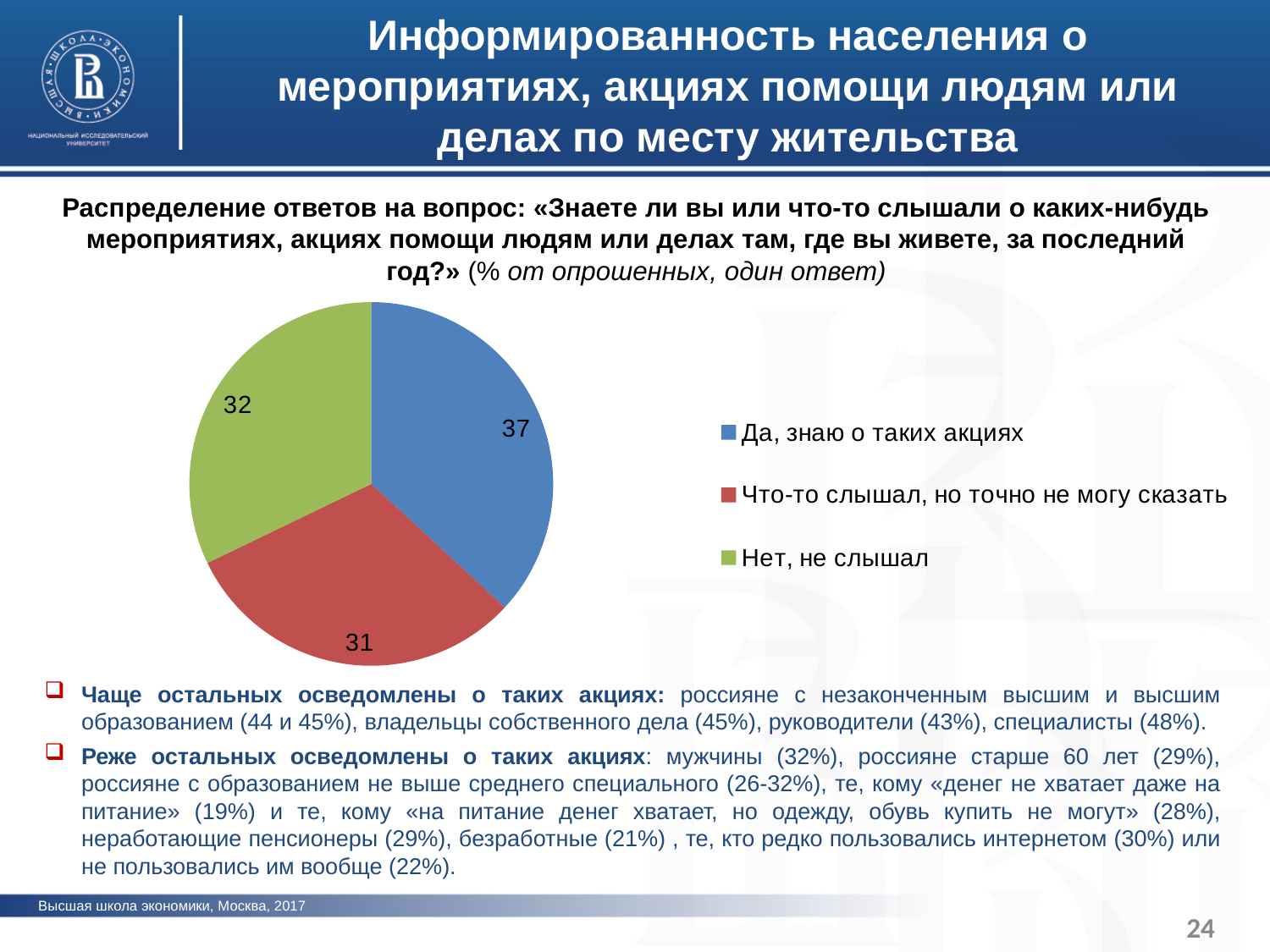
What colour is the slice for "Что-то слышал, но точно не могу сказать"? red What kind of chart is shown on the slide? pie chart What value is shown for the slice "Да, знаю о таких акциях"? 37 Which answer option has the largest slice in the pie chart? Да, знаю о таких акциях What is the difference between the values for "Да, знаю о таких акциях" and "Что-то слышал, но точно не могу сказать"? 6 What value is shown for the slice "Что-то слышал, но точно не могу сказать"? 31 What value is shown for the slice "Нет, не слышал"? 32 How many slices does the pie chart have? 3 What colour is the slice for "Нет, не слышал"? green What is the difference between the values for "Да, знаю о таких акциях" and "Нет, не слышал"? 5 Which is larger: the slice for "Да, знаю о таких акциях" or the slice for "Нет, не слышал"? Да, знаю о таких акциях How many entries does the legend list? 3